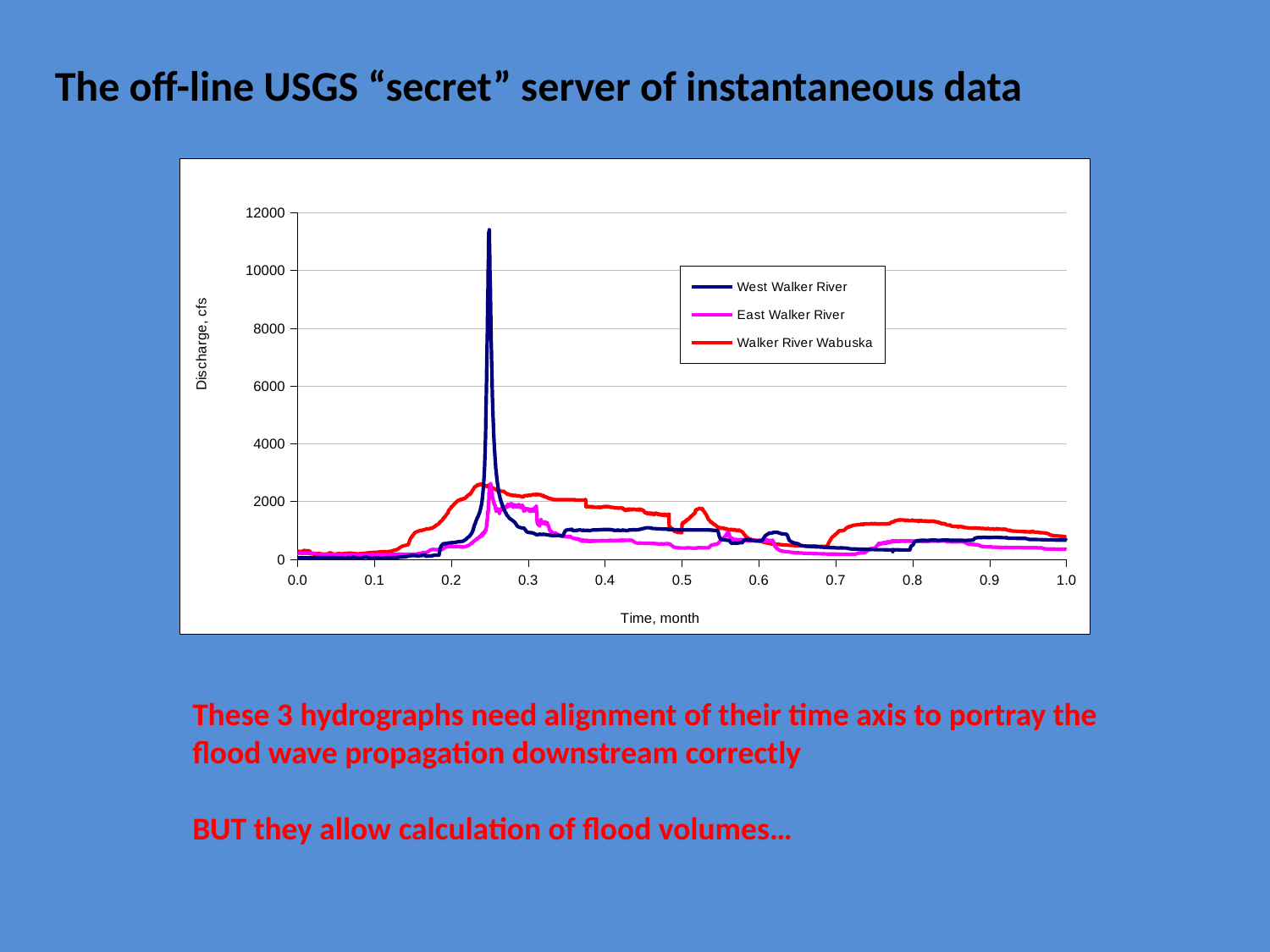
What colour is the line for Walker River Wabuska? red Is the peak value for West Walker River greater or less than 10000? greater What kind of chart is shown on the slide? line chart What is the label of the vertical axis? Discharge, cfs Is the peak value for Walker River Wabuska greater or less than 4000? less At time 0.7 month, which series has the larger discharge, Walker River Wabuska or East Walker River? Walker River Wabuska At time 0.15 month, which series has the larger discharge, Walker River Wabuska or West Walker River? Walker River Wabuska How many series does the legend list? 3 What is the highest value shown on the vertical axis? 12000 Is the peak value for East Walker River greater or less than 4000? less Which series reaches the highest peak discharge? West Walker River How many tick labels are shown on the horizontal axis? 11